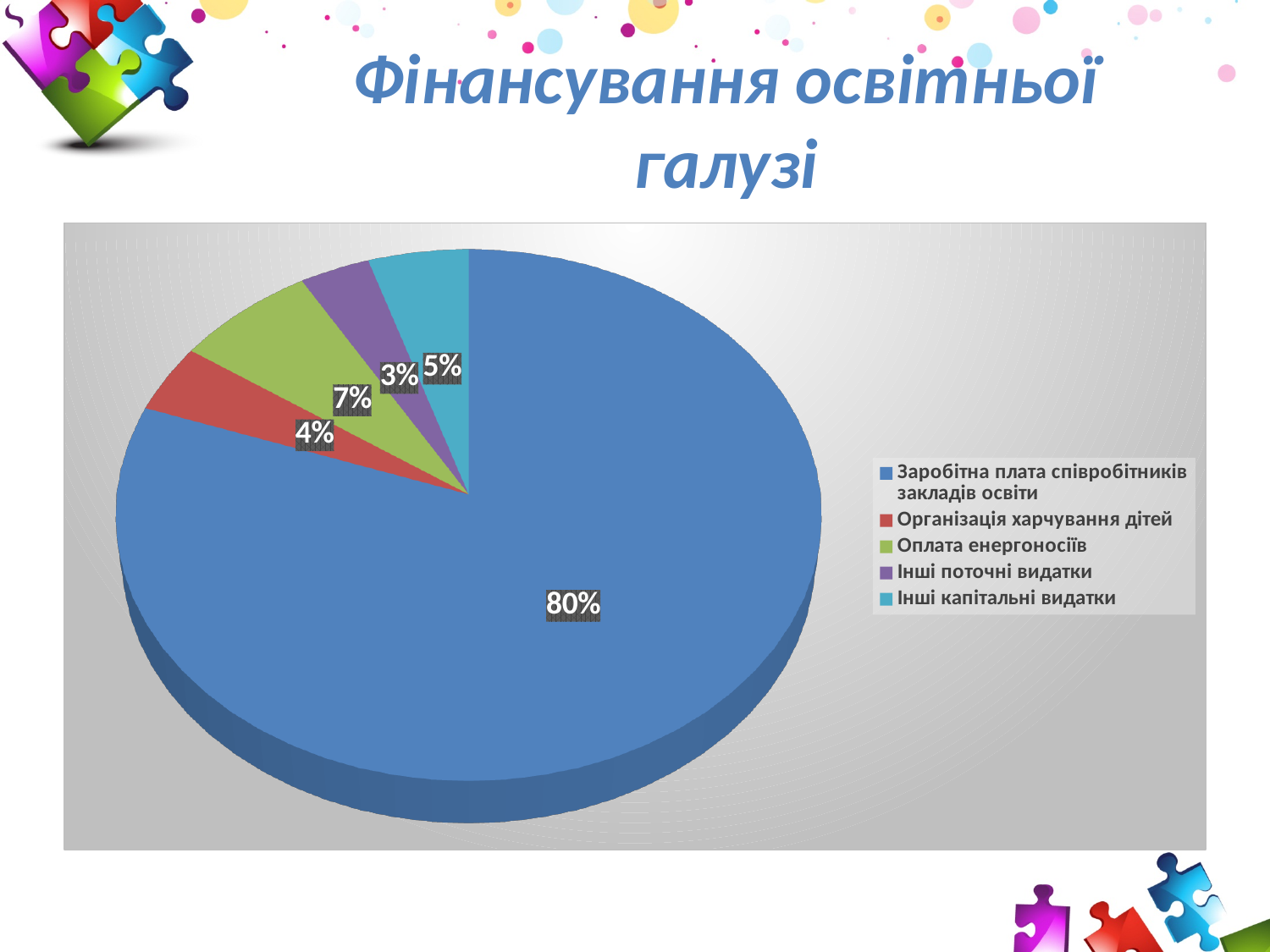
What is the difference between the shares of "Оплата енергоносіїв" and "Організація харчування дітей"? 3% Which category has the largest slice of the pie? Заробітна плата співробітників закладів освіти Which is larger: the share for "Інші капітальні видатки" or the share for "Інші поточні видатки"? Інші капітальні видатки What is the value shown for "Інші поточні видатки"? 3% What share of the pie does "Заробітна плата співробітників закладів освіти" take? 80% What is the title of the slide containing the chart? Фінансування освітньої галузі Which category has the smallest slice of the pie? Інші поточні видатки What kind of chart is shown on the slide? pie chart What is the value shown for "Організація харчування дітей"? 4% What is the value shown for "Інші капітальні видатки"? 5% How many categories does the pie chart have? 5 What is the value shown for "Оплата енергоносіїв"? 7%